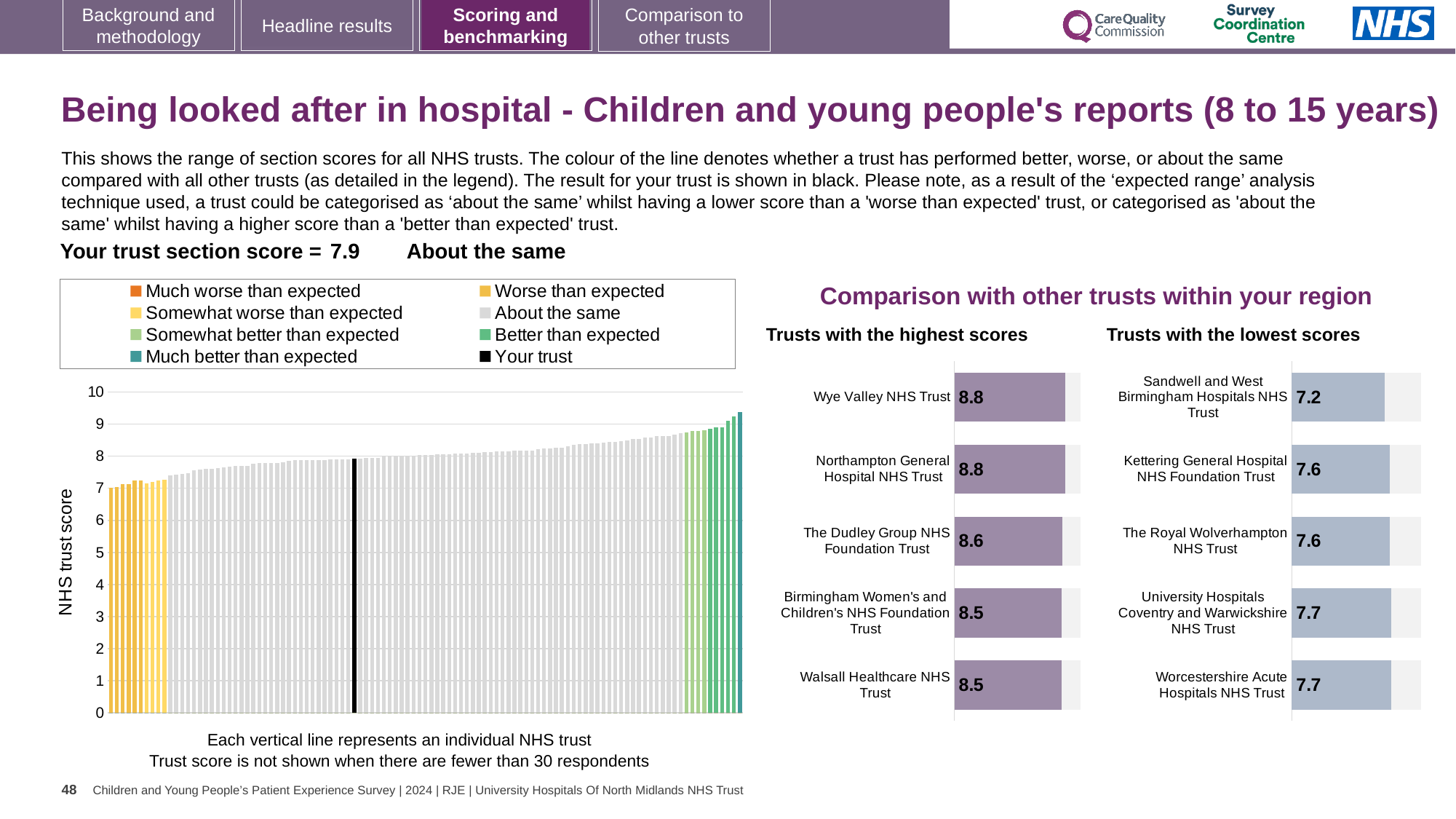
In the 'Trusts with the lowest scores' chart, what is the score for Kettering General Hospital NHS Foundation Trust? 7.6 Which has the higher score: The Dudley Group NHS Foundation Trust in the 'Trusts with the highest scores' chart or The Royal Wolverhampton NHS Trust in the 'Trusts with the lowest scores' chart? The Dudley Group NHS Foundation Trust In the 'Trusts with the highest scores' chart, what is the score for The Dudley Group NHS Foundation Trust? 8.6 In the 'Trusts with the lowest scores' chart, which trust has the lowest score? Sandwell and West Birmingham Hospitals NHS Trust In the 'Trusts with the highest scores' chart, what is the difference between the scores for Wye Valley NHS Trust and Walsall Healthcare NHS Trust? 0.3 How many entries does the legend of the large chart on the left list? 8 What is the difference between the score for Wye Valley NHS Trust in the 'Trusts with the highest scores' chart and the score for Sandwell and West Birmingham Hospitals NHS Trust in the 'Trusts with the lowest scores' chart? 1.6 In the 'Trusts with the lowest scores' chart, what is the score for Sandwell and West Birmingham Hospitals NHS Trust? 7.2 In the large chart on the left showing the range of section scores, is the value for the lowest-scoring trust greater or less than 5? greater In the 'Trusts with the highest scores' chart, what is the score for Wye Valley NHS Trust? 8.8 How many trusts are listed in the 'Trusts with the lowest scores' chart? 5 In the large chart on the left showing the range of section scores, do the trust scores rise or fall from left to right? rise